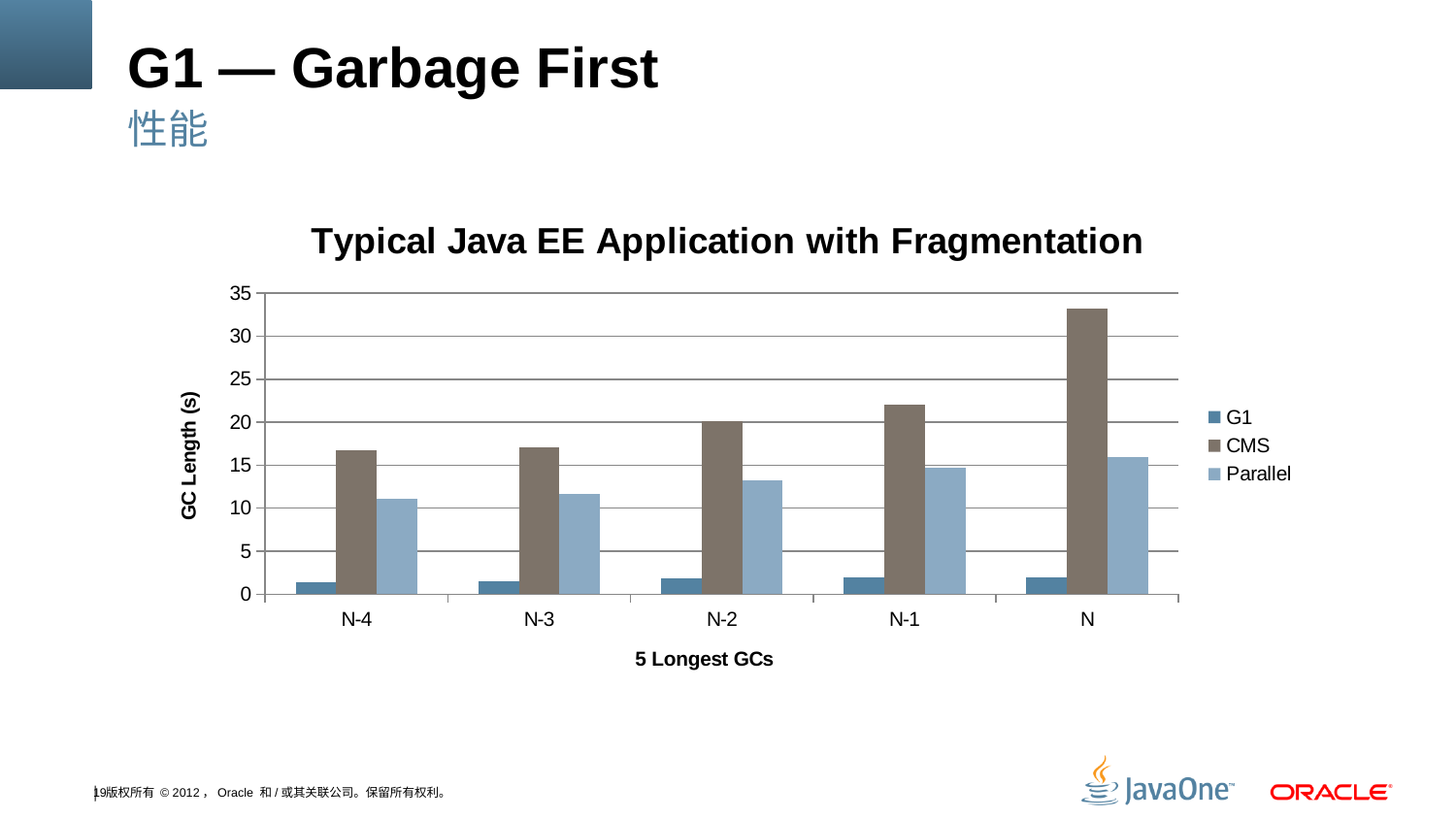
For the CMS series, which category has the highest value? N How many series does the legend list? 3 What type of chart is shown on the slide? bar chart What is the title of the chart? Typical Java EE Application with Fragmentation Is the CMS value for N greater or less than 30? greater Is the Parallel value for N-4 greater or less than 15? less Which series has the highest value for category N? CMS Do the CMS values rise or fall from N-4 to N? rise How many categories are shown on the x axis? 5 Which series has the lowest value for category N-2? G1 Which is larger, the CMS value for N-1 or the Parallel value for N-1? CMS Is the G1 value for N-1 greater or less than 5? less